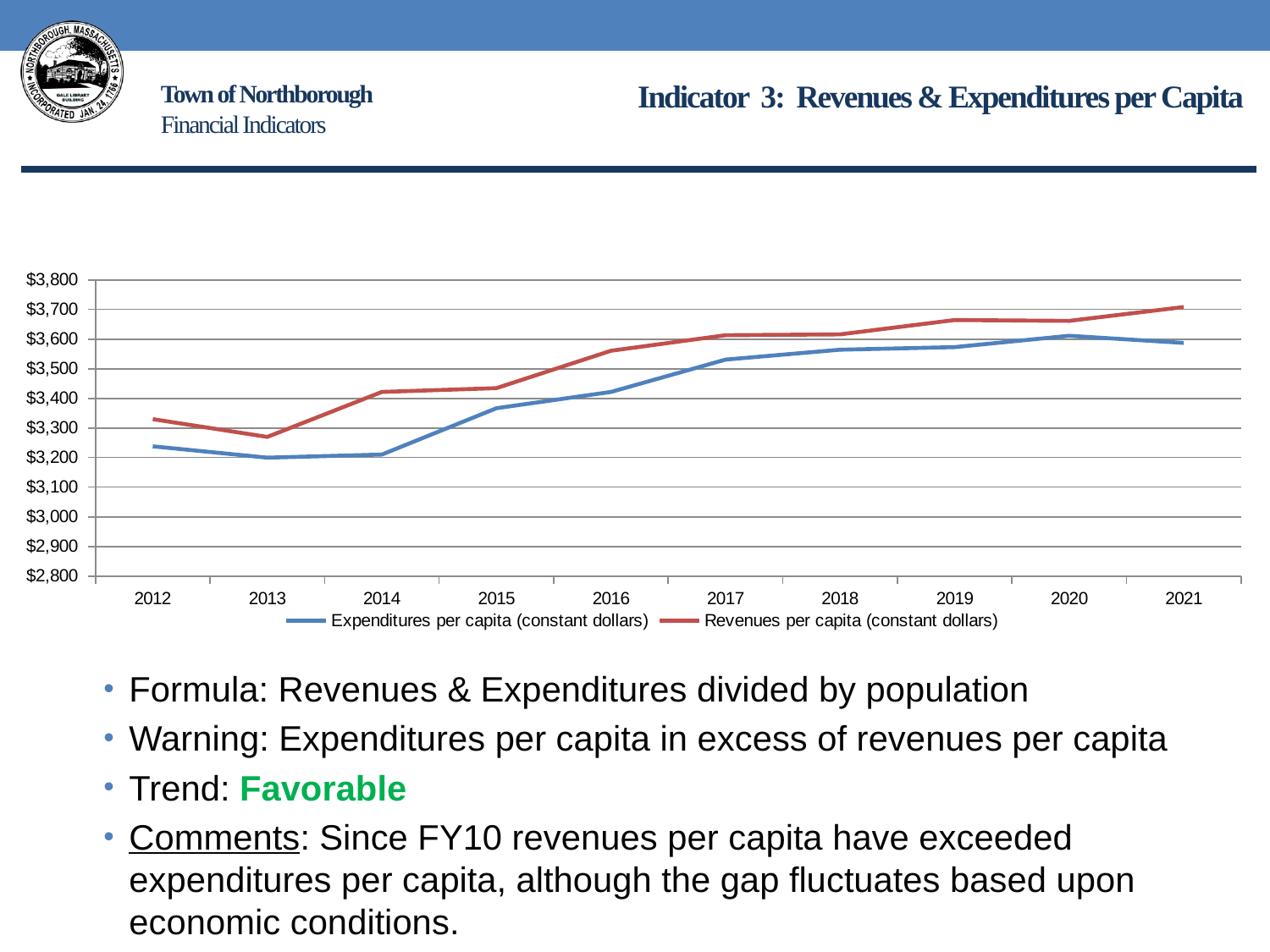
Which year has the highest value for Revenues per capita (constant dollars)? 2021 Is the value for Revenues per capita in 2019 greater or less than $3,600? greater How many series does the chart legend list? 2 Which year has the lowest value for Revenues per capita (constant dollars)? 2013 Is the value for Expenditures per capita in 2012 greater or less than $3,300? less Is the value for Expenditures per capita in 2015 greater or less than $3,400? less How many years are plotted along the x axis of the chart? 10 What kind of chart is shown on the slide? Line chart What colour is the line for Revenues per capita (constant dollars)? Red In 2016, which is larger: Revenues per capita or Expenditures per capita? Revenues per capita Overall, do Revenues per capita rise or fall from 2013 to 2021? Rise